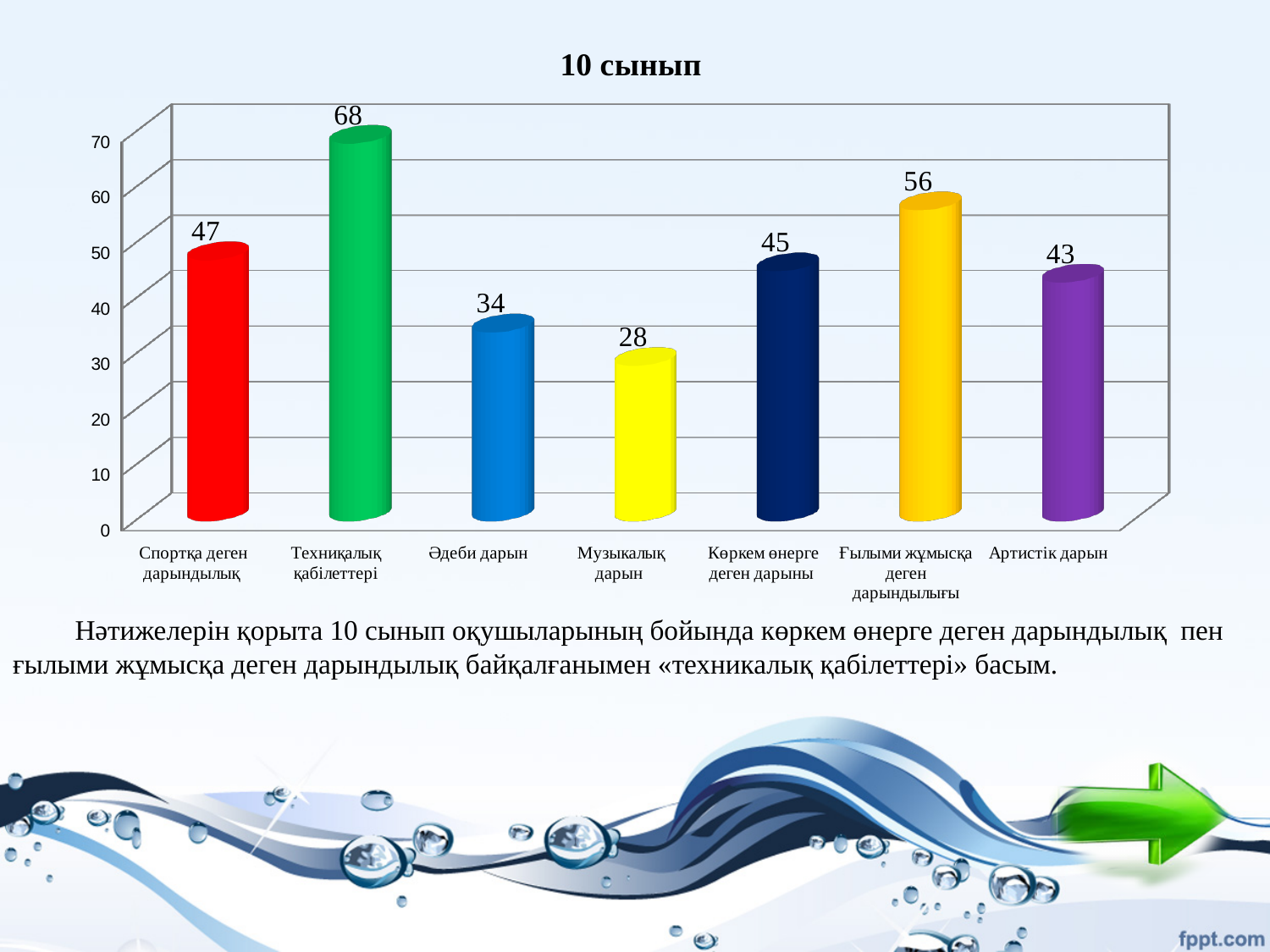
What is the title of the chart? 10 сынып What is the value for Техникалық қабілеттері? 68 What is the difference between the values for Техникалық қабілеттері and Спортқа деген дарындылық? 21 What is the value for Ғылыми жұмысқа деген дарындылығы? 56 What kind of chart is shown on the slide? bar chart Which category has the highest value? Техникалық қабілеттері What is the value for Музыкалық дарын? 28 Which category has the lowest value? Музыкалық дарын What is the difference between the values for Ғылыми жұмысқа деген дарындылығы and Артистік дарын? 13 Is the value for Әдеби дарын greater or less than 40? less Which is larger, the value for Спортқа деген дарындылық or the value for Көркем өнерге деген дарыны? Спортқа деген дарындылық How many categories are shown in the chart? 7